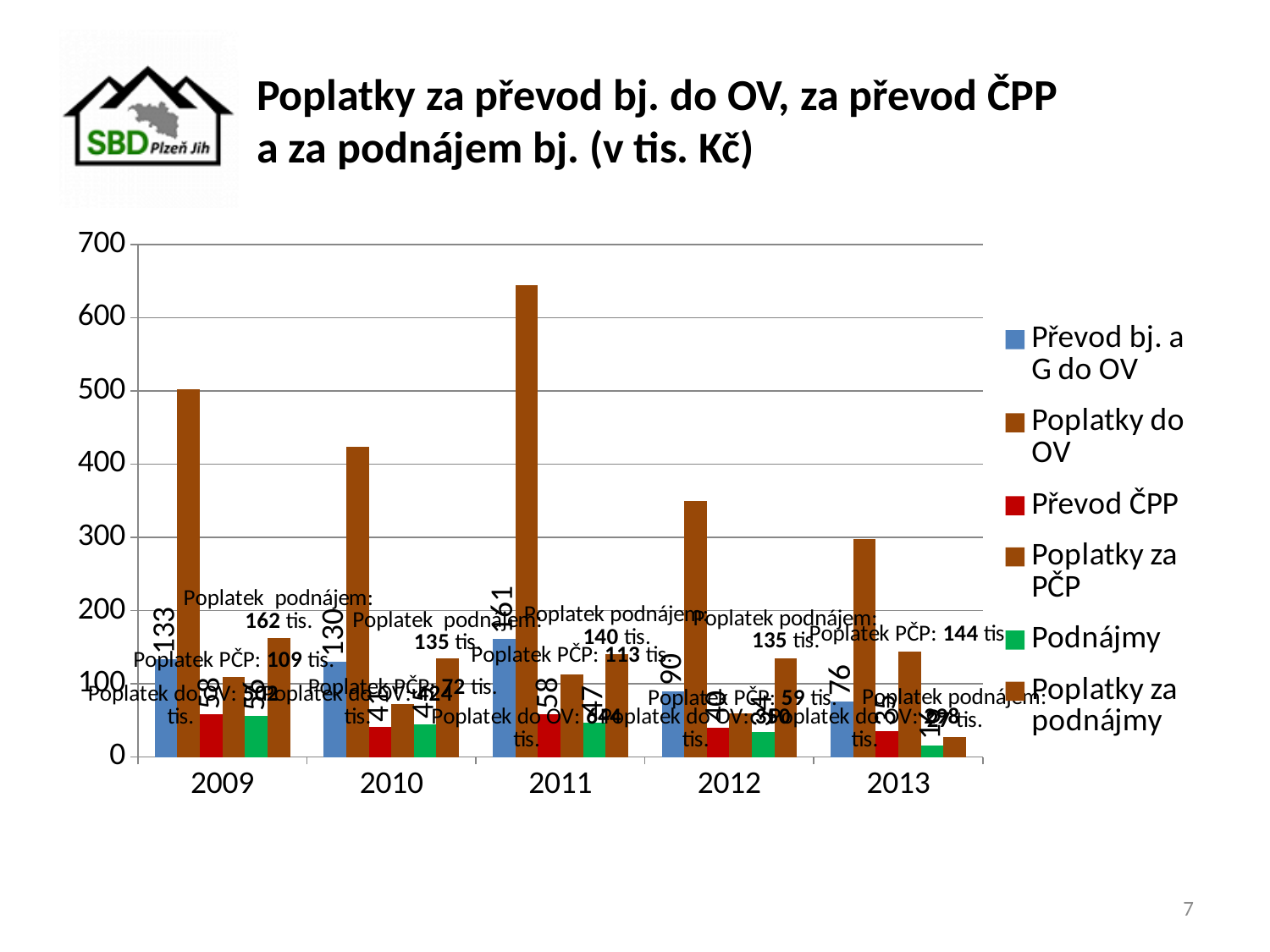
Which is larger, the 'Převod bj. a G do OV' value for 2009 or for 2012? 2009 How many years are shown on the x axis of the chart? 5 In which year is 'Převod bj. a G do OV' highest? 2011 What is the difference between the 'Převod bj. a G do OV' values for 2011 and 2013? 85 What is the value of 'Převod bj. a G do OV' for 2013? 76 What is the value of 'Převod bj. a G do OV' for 2011? 161 What kind of chart is shown on the slide? bar chart How many series does the chart legend list? 6 According to the text label, what is 'Poplatek PČP' for 2013? 144 tis. In which year is 'Převod bj. a G do OV' lowest? 2013 Is the 'Poplatky do OV' bar for 2011 greater or less than 600? greater In which year is the 'Poplatky do OV' bar the tallest? 2011